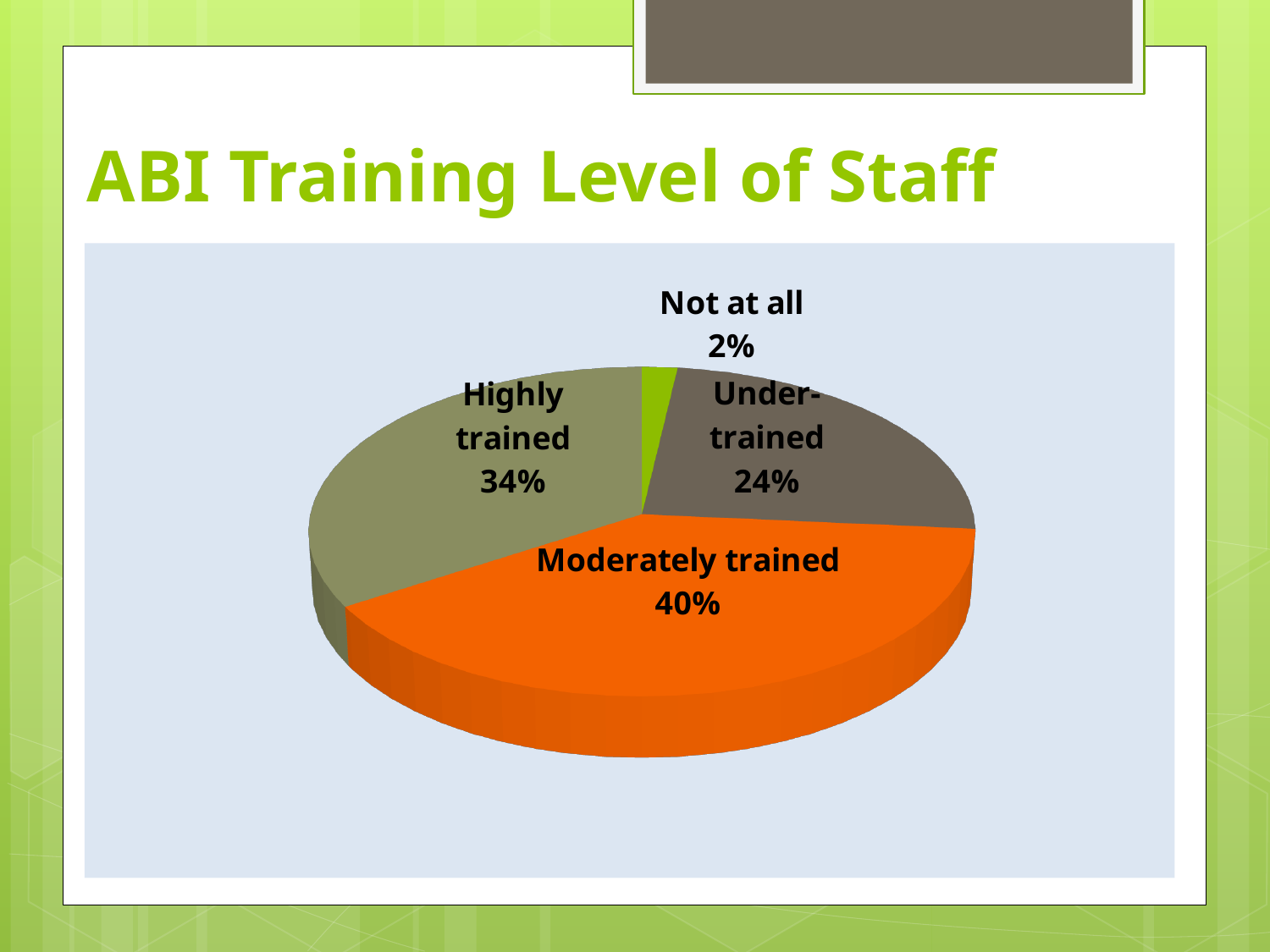
What percentage of staff are highly trained? 34% What is the title of the chart on the slide? ABI Training Level of Staff What is the difference in percentage points between moderately trained and highly trained staff? 6 What is the combined share of highly trained and moderately trained staff? 74% What percentage of staff are moderately trained? 40% What percentage of staff are under-trained? 24% What kind of chart is shown on the slide? pie chart Which training level has the largest share of staff? Moderately trained Which training level has the smallest share of staff? Not at all How many slices does the pie chart have? 4 What percentage of staff are not trained at all? 2% Which is larger, the share of highly trained staff or the share of under-trained staff? Highly trained